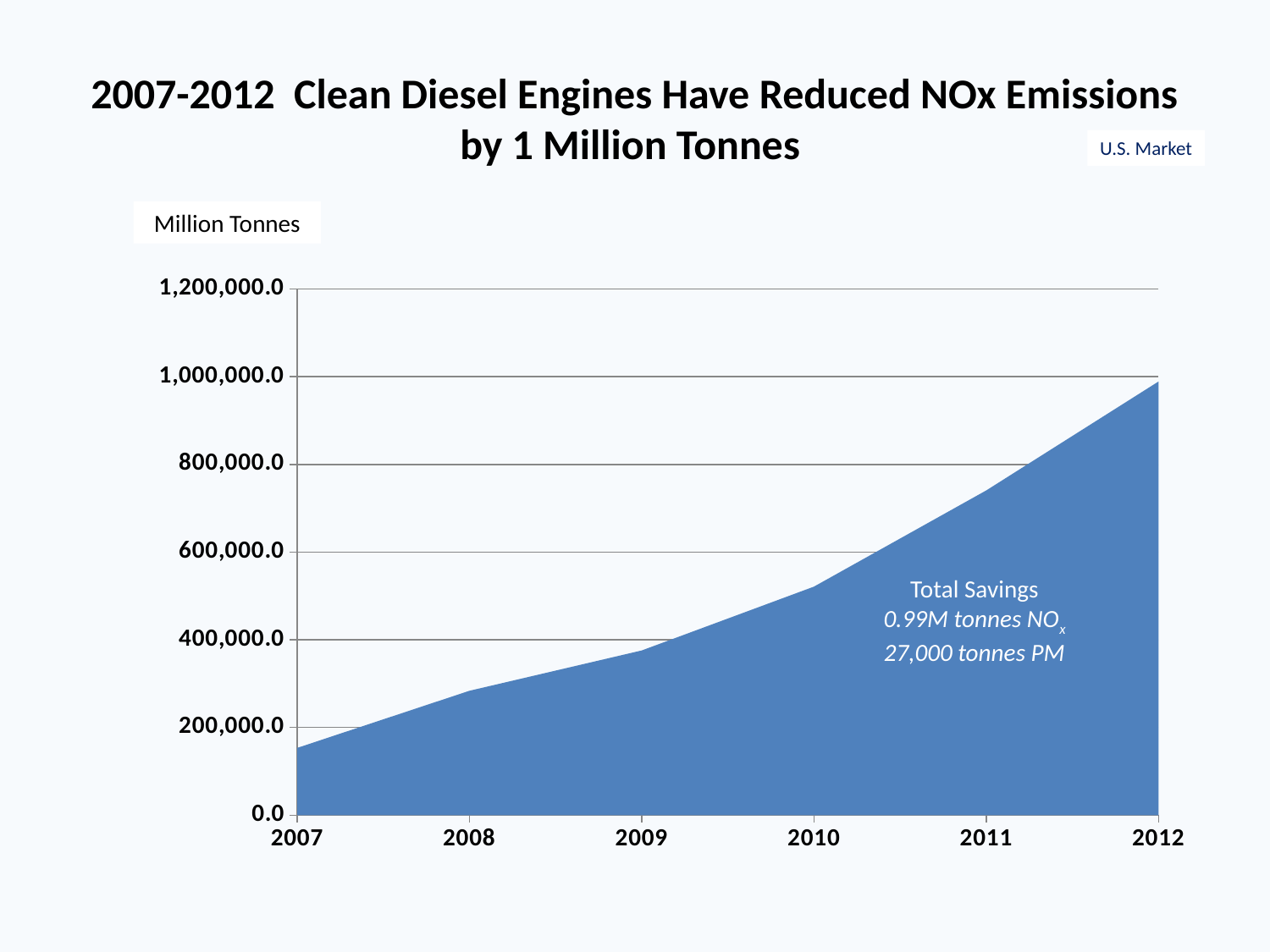
Is the value for 2012 greater or less than 800,000.0? greater Is the value for 2007 greater or less than 200,000.0? less What kind of chart is shown on the slide? area chart Is the value for 2011 greater or less than 600,000.0? greater How many years are plotted along the x axis? 6 Which year has the larger value, 2008 or 2010? 2010 What is the title of the chart? 2007-2012 Clean Diesel Engines Have Reduced NOx Emissions by 1 Million Tonnes Which year has the lowest value? 2007 Which year has the highest value? 2012 Do the values rise or fall from 2007 to 2012? rise What unit label is shown above the y axis? Million Tonnes